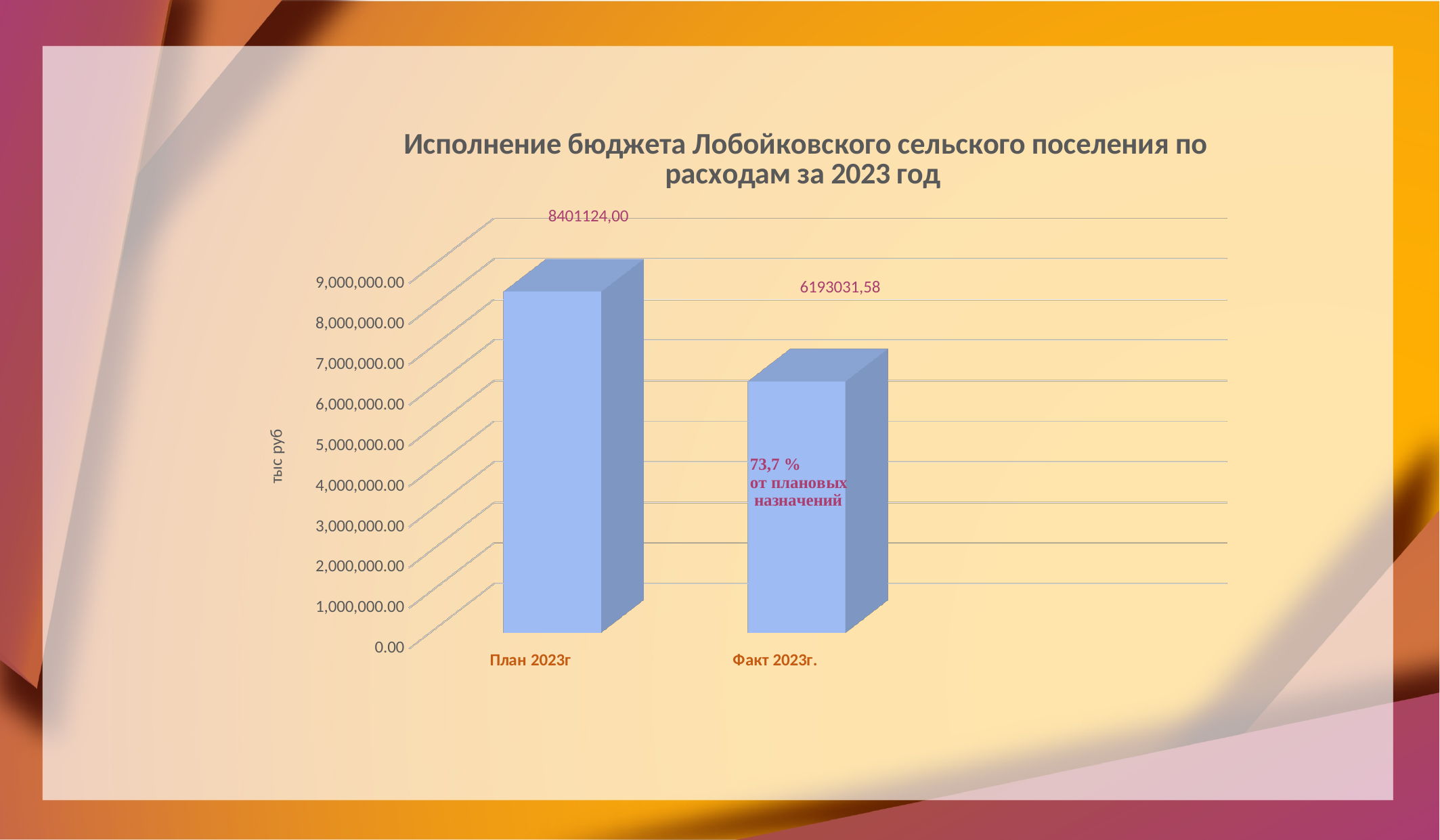
What kind of chart is shown on the slide? bar chart What is the value for Факт 2023г.? 6193031,58 Is the value for Факт 2023г. greater or less than 7,000,000.00? less How many categories are shown on the chart? 2 What percentage of planned appropriations does the Факт 2023г. bar represent, according to the annotation on the chart? 73,7 % What is the label of the vertical axis? тыс руб Which category has the highest value? План 2023г What is the difference between the values for План 2023г and Факт 2023г.? 2208092,42 What is the value for План 2023г? 8401124,00 Which is larger, the value for План 2023г or the value for Факт 2023г.? План 2023г Is the value for План 2023г greater or less than 8,000,000.00? greater Which category has the lowest value? Факт 2023г.